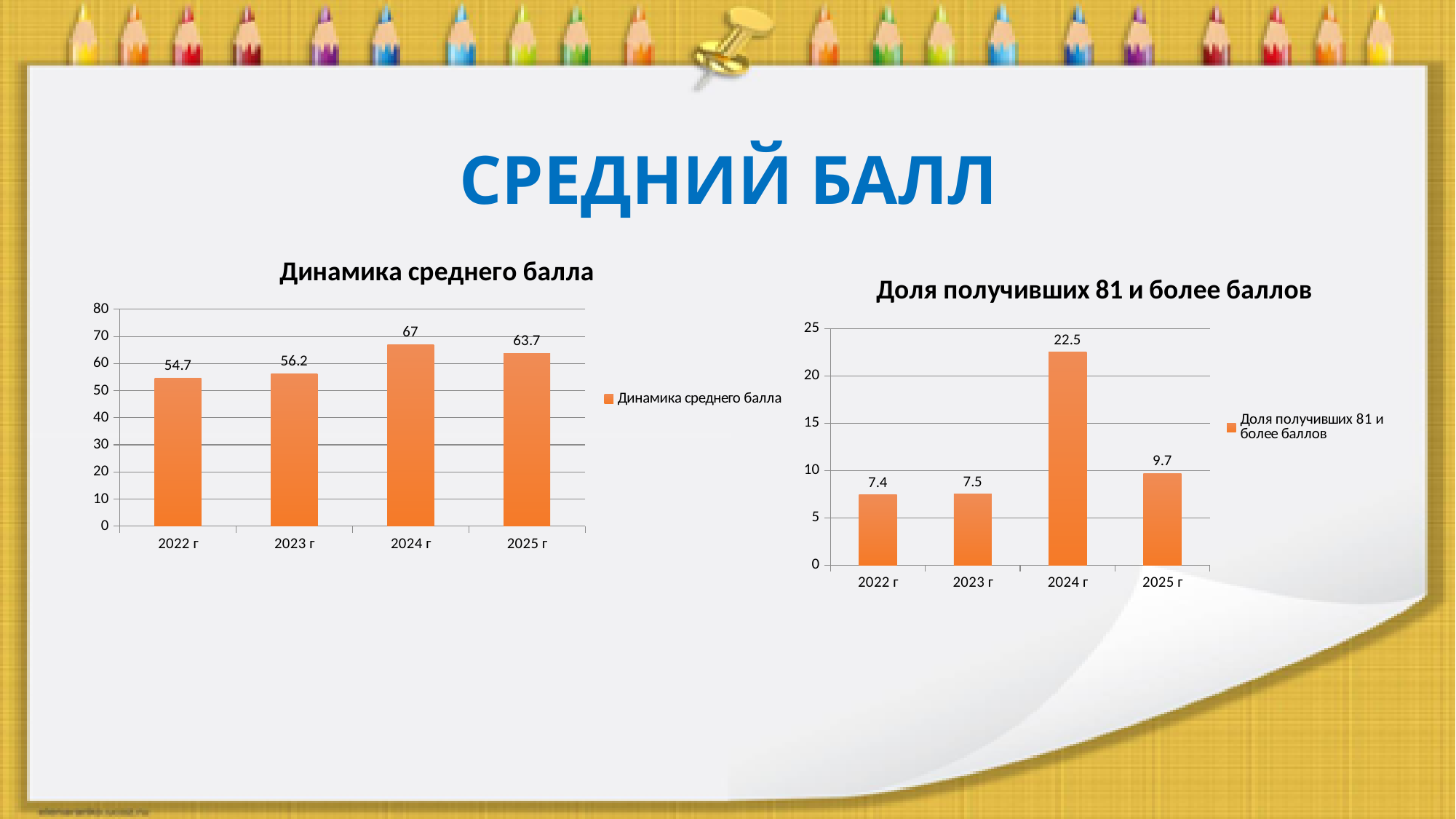
In the chart 'Динамика среднего балла', which year has the highest value? 2024 г What kind of chart is 'Доля получивших 81 и более баллов'? bar chart In the chart 'Динамика среднего балла', what is the difference between the values for 2024 г and 2025 г? 3.3 In the chart 'Динамика среднего балла', what is the value for 2022 г? 54.7 How many categories are shown on the x axis of the chart 'Динамика среднего балла'? 4 In the chart 'Доля получивших 81 и более баллов', what is the value for 2024 г? 22.5 In the chart 'Динамика среднего балла', which year has the lowest value? 2022 г In the chart 'Динамика среднего балла', what is the value for 2024 г? 67 In the chart 'Доля получивших 81 и более баллов', what is the difference between the values for 2024 г and 2022 г? 15.1 In the chart 'Доля получивших 81 и более баллов', which year has the highest value? 2024 г In the chart 'Доля получивших 81 и более баллов', is the value for 2023 г greater or less than 10? less In the chart 'Доля получивших 81 и более баллов', what is the value for 2025 г? 9.7